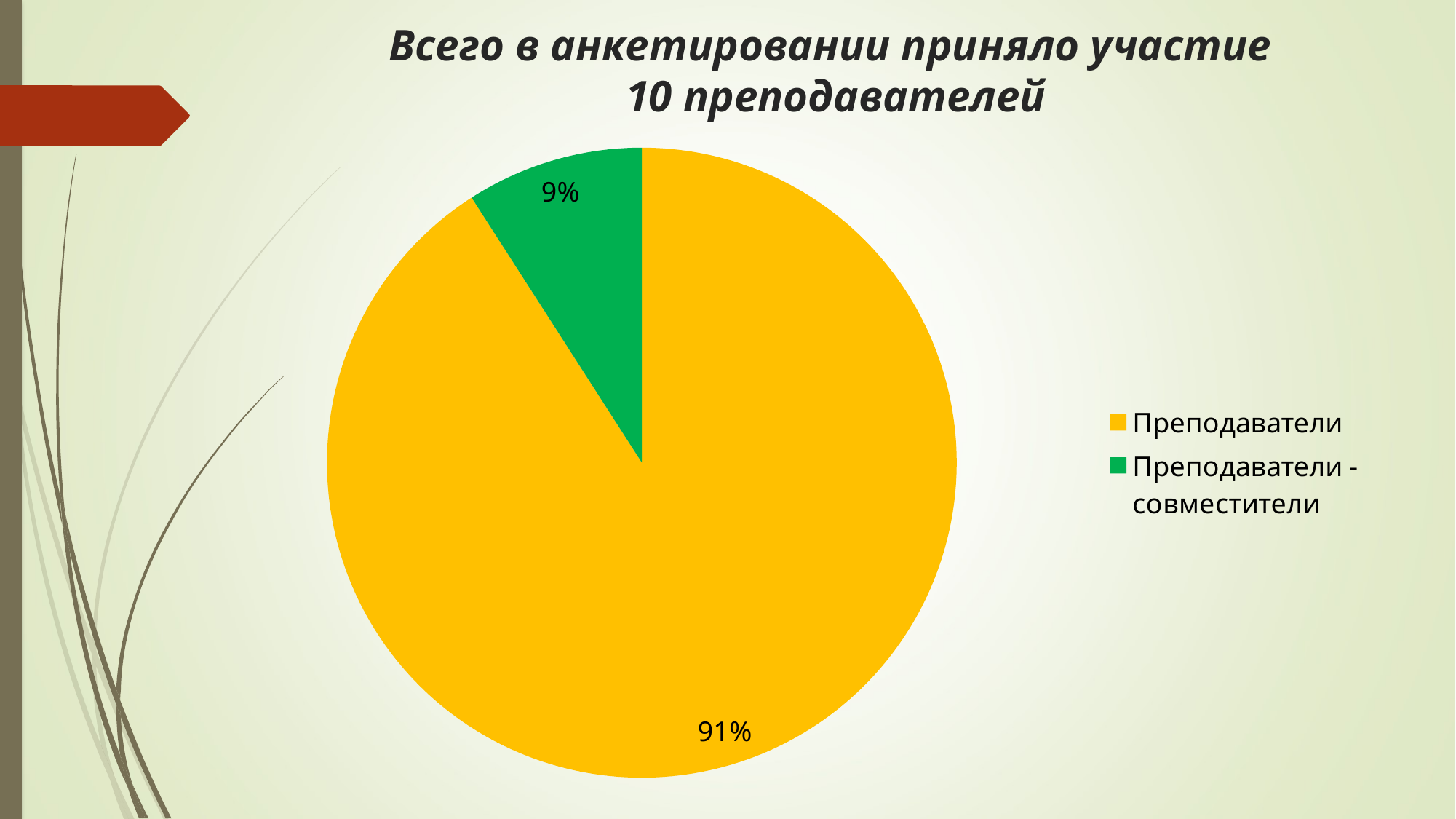
What is the title of the slide above the chart? Всего в анкетировании приняло участие 10 преподавателей Which category has the smallest slice of the pie? Преподаватели - совместители What percentage is shown for Преподаватели - совместители? 9% What percentage is shown for Преподаватели? 91% Which is larger: the share for Преподаватели or for Преподаватели - совместители? Преподаватели Which category has the largest slice of the pie? Преподаватели How many entries does the legend list? 2 What colour is the slice for Преподаватели - совместители? green What is the difference in percentage points between Преподаватели and Преподаватели - совместители? 82 Is the share for Преподаватели - совместители greater or less than 50%? less How many slices does the pie chart have? 2 What kind of chart is shown on the slide? pie chart